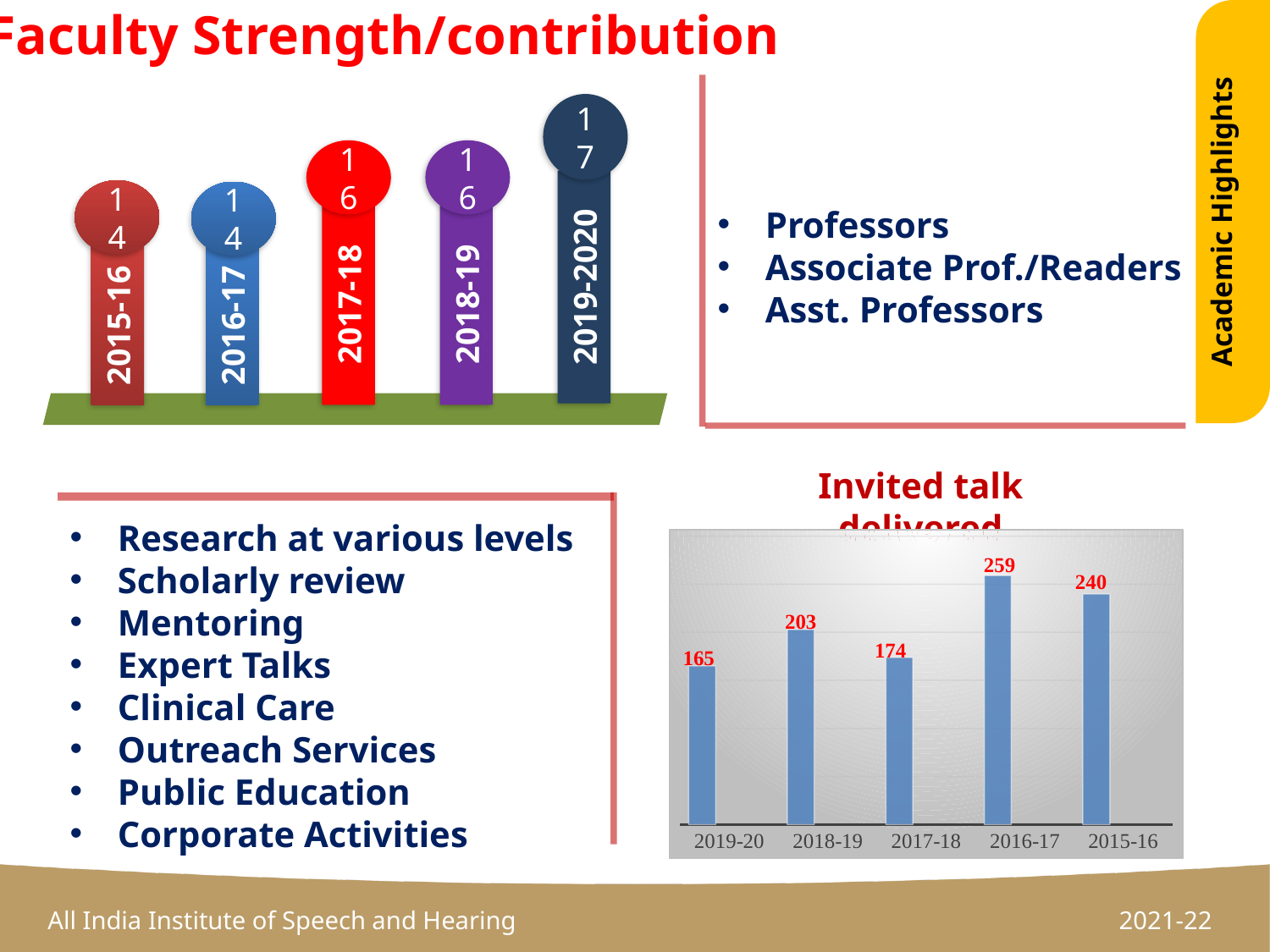
In the 'Invited talk delivered' chart, what is the value for 2016-17? 259 In the faculty strength chart at the top left, what is the difference between the values for 2019-2020 and 2016-17? 3 How many bars are shown in the 'Invited talk delivered' chart? 5 In the 'Invited talk delivered' chart, which year has the lowest value? 2019-20 In the 'Invited talk delivered' chart, what is the value for 2018-19? 203 In the 'Invited talk delivered' chart, what is the value for 2019-20? 165 In the faculty strength chart at the top left, what is the value for 2015-16? 14 In the 'Invited talk delivered' chart, which is larger, the value for 2018-19 or the value for 2017-18? 2018-19 In the 'Invited talk delivered' chart, what is the difference between the values for 2016-17 and 2019-20? 94 In the 'Invited talk delivered' chart, which year has the highest value? 2016-17 What kind of chart is the 'Invited talk delivered' chart? bar chart In the faculty strength chart at the top left, what is the value for 2019-2020? 17